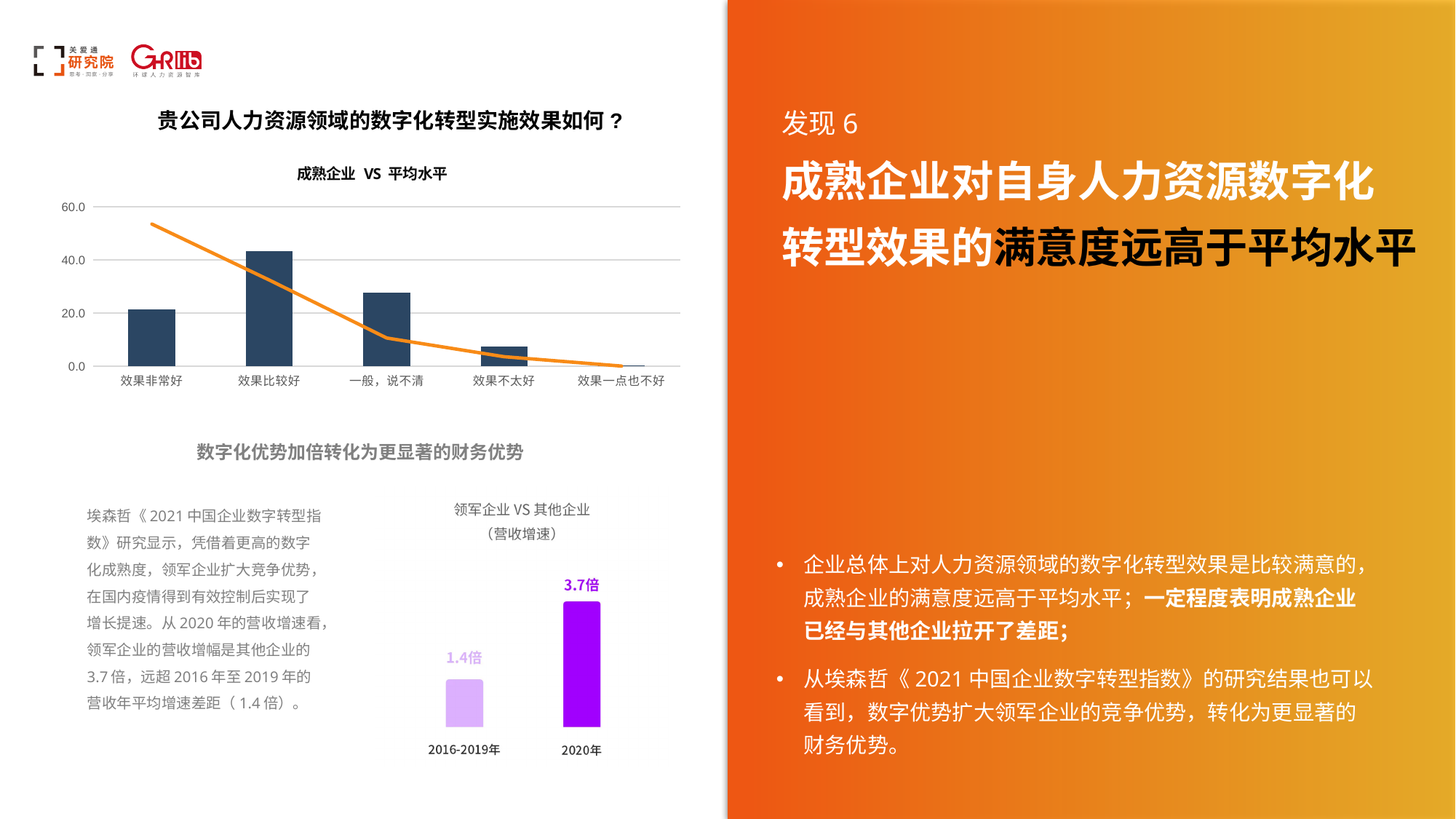
In the top chart titled 成熟企业 VS 平均水平, is the bar for 效果不太好 greater or less than 20.0? less In the bottom chart titled 领军企业 VS 其他企业（营收增速）, what is the value for 2020年? 3.7倍 In the top chart titled 成熟企业 VS 平均水平, which is larger, the bar for 效果非常好 or the bar for 一般，说不清? 一般，说不清 In the top chart titled 成熟企业 VS 平均水平, what kind of chart is it? A bar chart with a line overlay In the top chart titled 成熟企业 VS 平均水平, is the line value for 效果非常好 greater or less than 40.0? greater In the bottom chart titled 领军企业 VS 其他企业（营收增速）, which period has the higher value? 2020年 In the top chart titled 成熟企业 VS 平均水平, how many categories are shown on the x axis? 5 In the top chart titled 成熟企业 VS 平均水平, is the bar for 效果比较好 greater or less than 40.0? greater In the top chart titled 成熟企业 VS 平均水平, which category has the tallest bar? 效果比较好 In the top chart titled 成熟企业 VS 平均水平, does the orange line rise or fall from left to right across the categories? It falls In the top chart titled 成熟企业 VS 平均水平, which category has the shortest bar? 效果一点也不好 In the bottom chart titled 领军企业 VS 其他企业（营收增速）, what is the value for 2016-2019年? 1.4倍